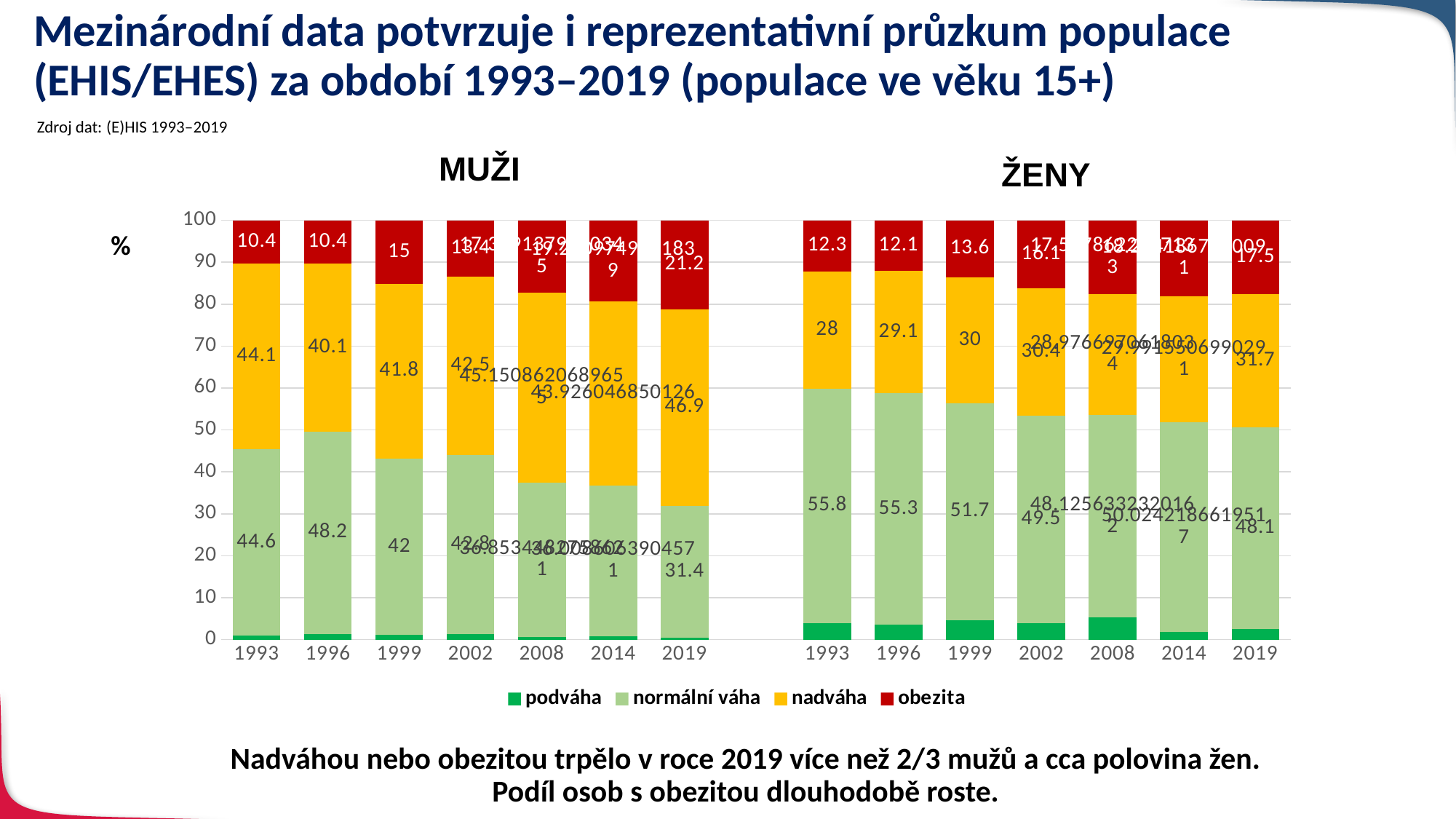
How many series does the legend list? 4 In the ŽENY chart, what is the value of normální váha for 1993? 55.8 In the MUŽI chart, does the obezita value rise or fall from 1993 to 2019? Rises What kind of chart is the ŽENY chart? Stacked bar chart In the MUŽI chart, which year has the highest obezita value? 2019 How many years are shown on the x axis of the MUŽI chart? 7 For 2019, which chart shows the larger obezita value, MUŽI or ŽENY? MUŽI In the MUŽI chart, what is the value of obezita for 2019? 21.2 In the ŽENY chart, what is the difference between the obezita value for 2019 and for 1993? 5.2 In the ŽENY chart, what is the value of nadváha for 2019? 31.7 In the MUŽI chart, which year has the lowest normální váha value? 2019 In the MUŽI chart, what is the value of obezita for 1993? 10.4